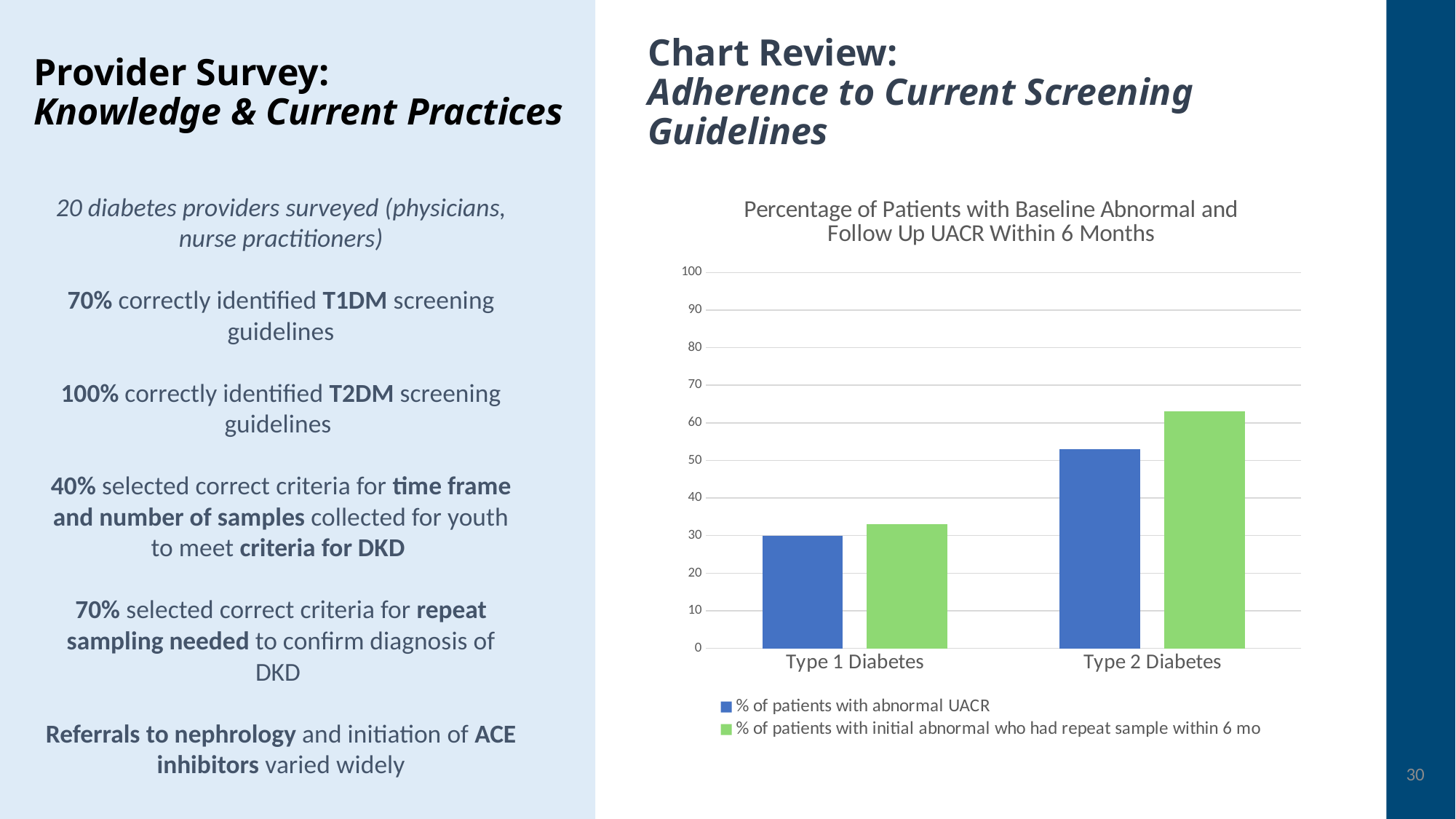
Is the value for '% of patients with initial abnormal who had repeat sample within 6 mo' for Type 1 Diabetes greater or less than 40? less Is the value for '% of patients with initial abnormal who had repeat sample within 6 mo' for Type 2 Diabetes greater or less than 60? greater What is the title of the chart? Percentage of Patients with Baseline Abnormal and Follow Up UACR Within 6 Months How many series does the chart legend list? 2 Is the value for '% of patients with abnormal UACR' for Type 2 Diabetes greater or less than 50? greater What kind of chart is shown on the slide? bar chart Which colour represents '% of patients with abnormal UACR' in the chart? blue Which category has the lowest value for '% of patients with abnormal UACR'? Type 1 Diabetes Which category has the higher value for '% of patients with abnormal UACR', Type 1 Diabetes or Type 2 Diabetes? Type 2 Diabetes How many categories are shown on the x axis of the chart? 2 Which category has the highest value for '% of patients with initial abnormal who had repeat sample within 6 mo'? Type 2 Diabetes